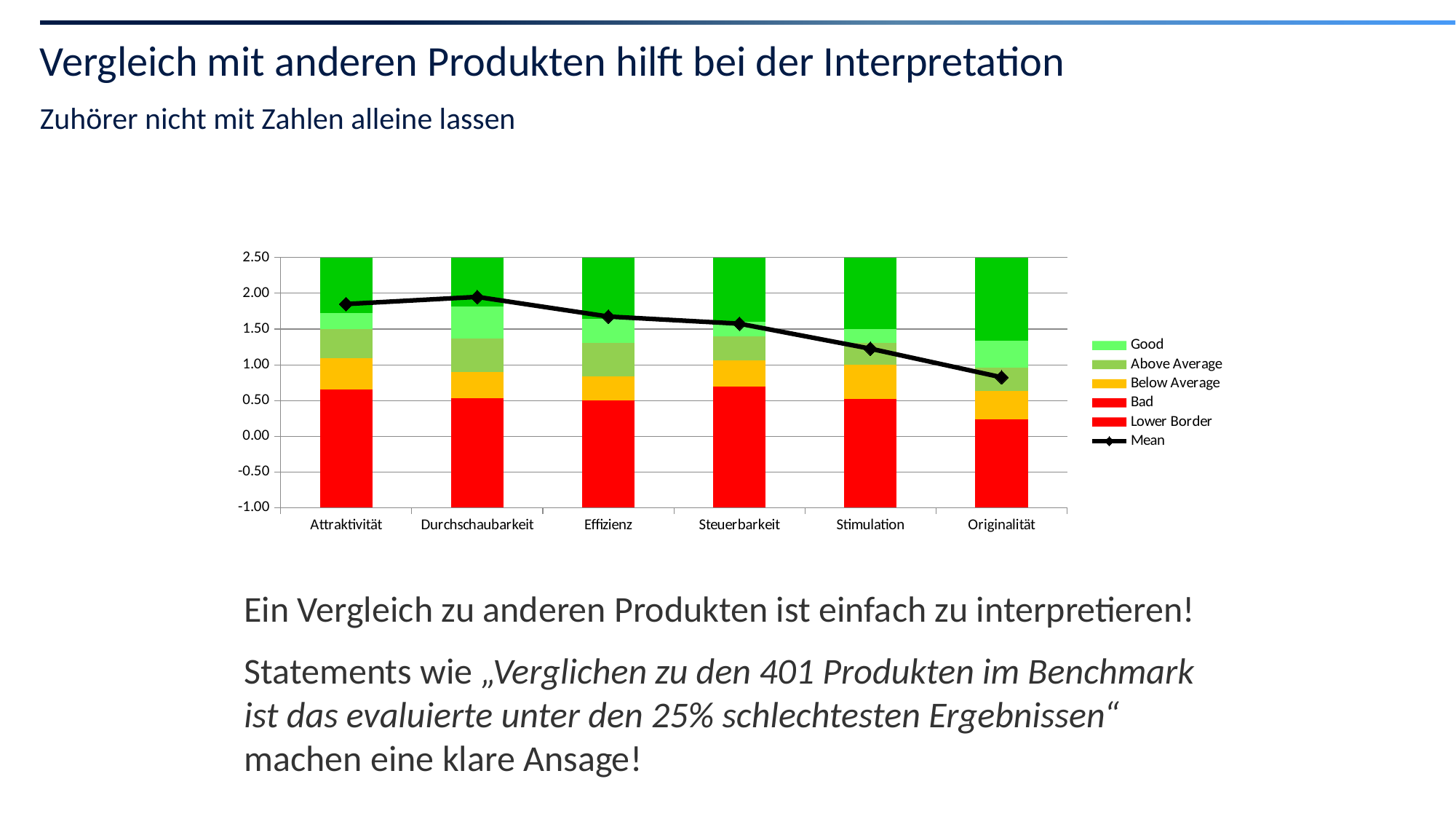
How many categories are shown on the x axis of the chart? 6 Is the Mean value for Attraktivität greater or less than 1.50? greater For which category is the Mean line highest? Durchschaubarkeit Which colour represents the 'Bad' series in the legend? Red Is the Mean value for Effizienz greater or less than 1.50? greater For which category is the Mean line lowest? Originalität Is the Mean value for Stimulation greater or less than 1.00? greater Which has the larger Mean value, Stimulation or Originalität? Stimulation Does the Mean line rise or fall from Durchschaubarkeit to Originalität? It falls What kind of chart is shown on the slide? A stacked bar chart with a line series (Mean) How many series does the chart's legend list? 6